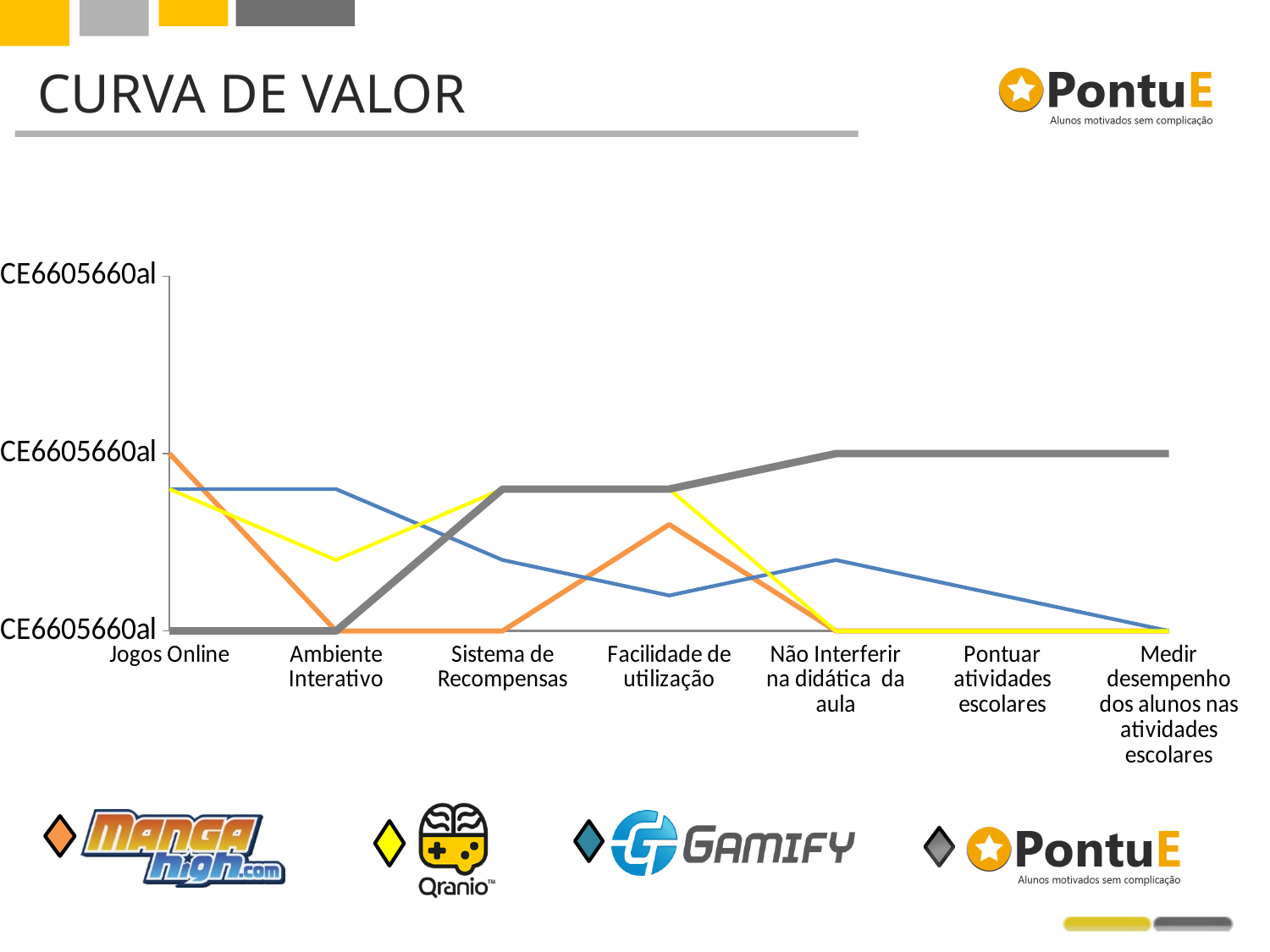
Does the blue (Gamify) line rise or fall overall from 'Jogos Online' to 'Medir desempenho dos alunos nas atividades escolares'? falls What kind of chart is shown on the slide? line chart Does the gray (PontuE) line rise or fall from 'Jogos Online' to 'Medir desempenho dos alunos nas atividades escolares'? rises At 'Medir desempenho dos alunos nas atividades escolares', which line has the highest value? gray (PontuE) At 'Facilidade de utilização', is the orange (Mangahigh) line higher or lower than the blue (Gamify) line? higher What is the title of the slide containing the chart? CURVA DE VALOR Which colour is the line for PontuE, according to the diamond markers next to the logos? gray At 'Jogos Online', which line has the highest value? orange (Mangahigh) How many categories are shown along the x axis of the chart? 7 How many series (lines) are plotted on the chart? 4 At which category does the orange (Mangahigh) line reach its highest value? Jogos Online